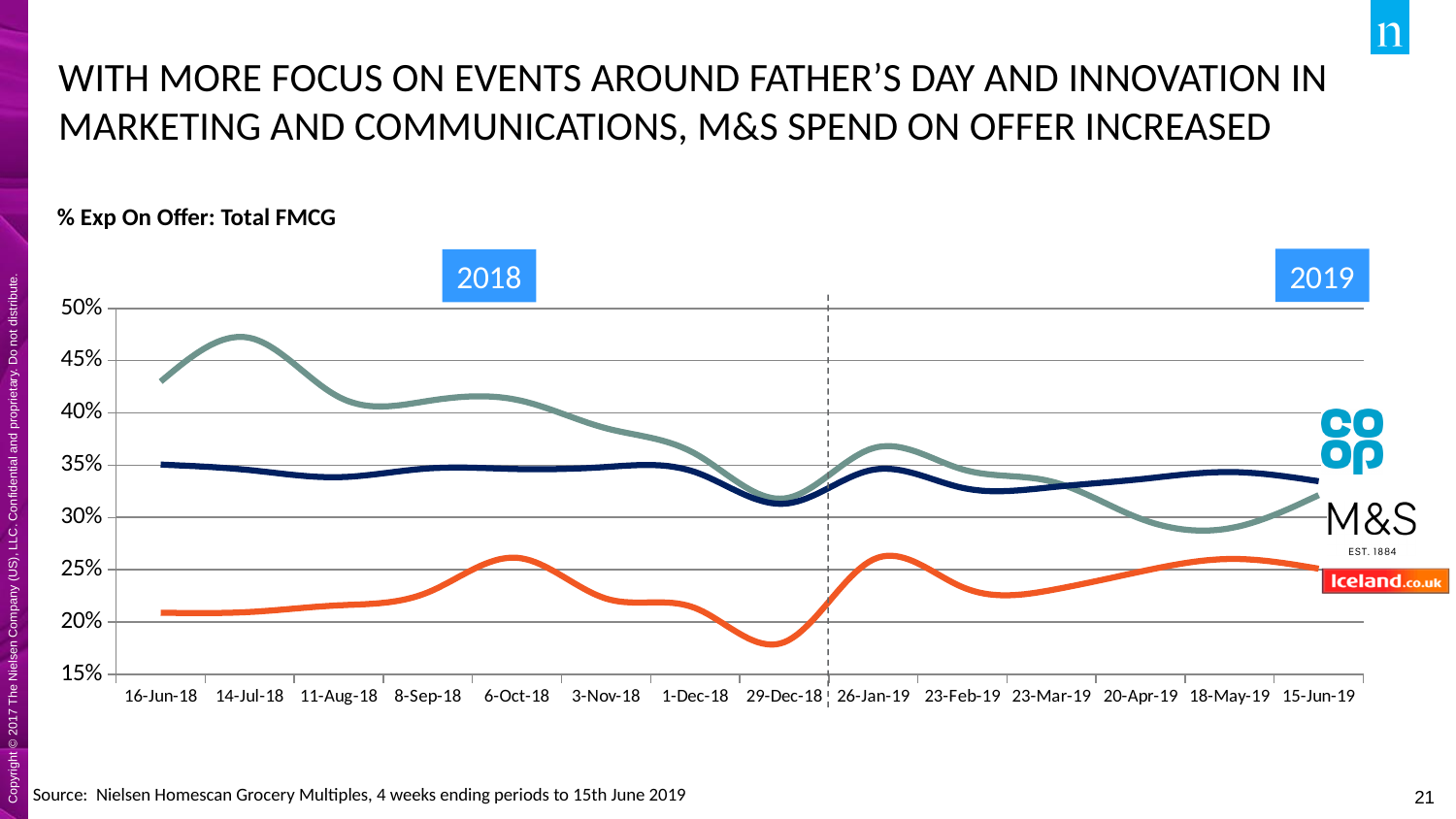
What type of chart is shown on the slide? line chart Is the value of the orange line at 29-Dec-18 greater or less than 20%? less Is the value of the grey-green line at 14-Jul-18 greater or less than 45%? greater Is the value of the orange line at 16-Jun-18 greater or less than 25%? less What is the title of the chart? % Exp On Offer: Total FMCG How many lines are plotted on the chart? 3 Which two year labels are shown above the chart? 2018 and 2019 Which line has the lowest values across the whole period shown? the orange line How many dates are labelled along the x axis of the chart? 14 Does the orange line rise or fall between 29-Dec-18 and 26-Jan-19? rise At 16-Jun-18, which line has the higher value: the grey-green line or the dark navy line? the grey-green line